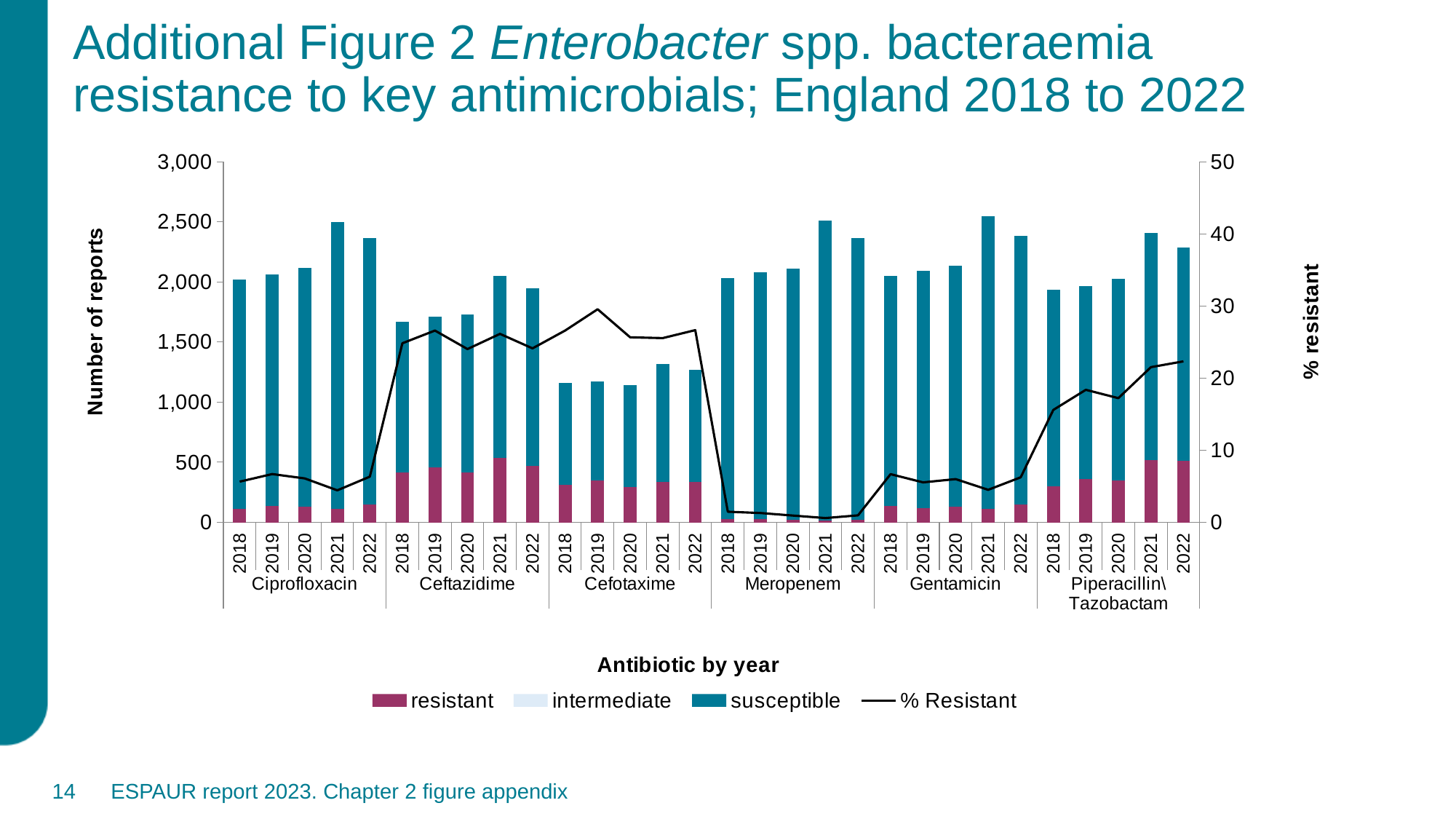
Is the total number of reports for Ciprofloxacin in 2021 greater or less than 2,000? greater What kind of chart is shown on the slide? combination bar and line chart Is the total number of reports for Cefotaxime in 2018 greater or less than 1,500? less How many series does the legend list? 4 Which antibiotic has the lowest % Resistant values on the line? Meropenem Which antibiotic has the highest % Resistant values on the line? Cefotaxime How many stacked bars are plotted in total? 30 Which year has the tallest total bar within the Ciprofloxacin group? 2021 Does the % Resistant line for Piperacillin\Tazobactam rise or fall from 2018 to 2022? rise How many antibiotics are shown along the x axis? 6 Is the % Resistant value for Meropenem in 2020 greater or less than 10? less